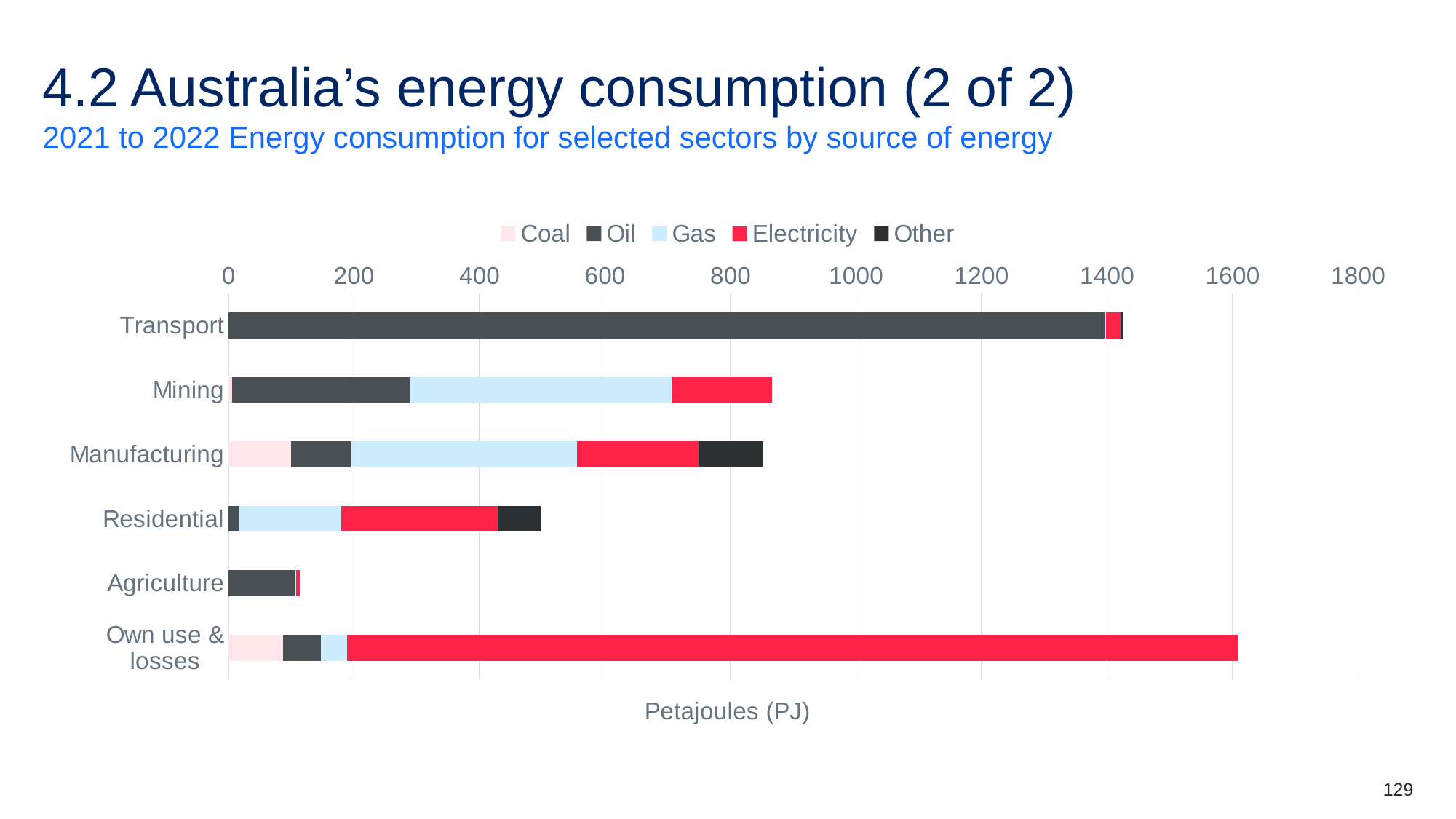
How many sectors are plotted on the chart? 6 Which sector has the longest total bar? Own use & losses Which sector has the shortest total bar? Agriculture What kind of chart is shown on the slide? Stacked bar chart Is the total value for Agriculture greater or less than 200? less What is the label on the horizontal axis? Petajoules (PJ) How many energy sources does the legend list? 5 Which has the larger total bar, Transport or Own use & losses? Own use & losses Is the total value for Own use & losses greater or less than 1400? greater Is the total value for Residential greater or less than 600? less Which energy source makes up almost all of the Transport bar? Oil